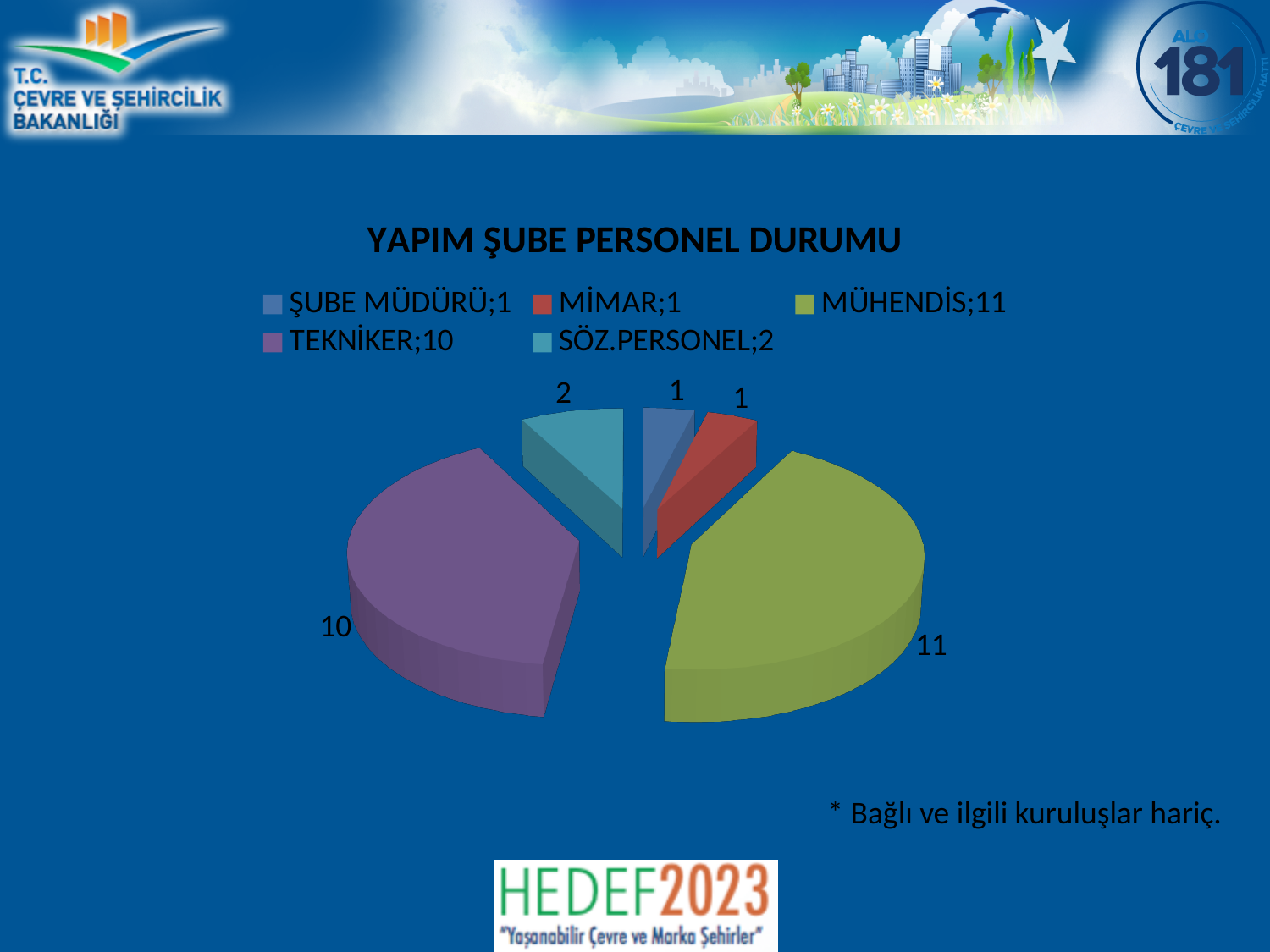
What is the difference between the values for MÜHENDİS and TEKNİKER? 1 What is the value for ŞUBE MÜDÜRÜ? 1 How many slices does the pie chart have? 5 What is the total of all slices in the pie chart? 25 What is the value for TEKNİKER? 10 Which is larger, the value for SÖZ.PERSONEL or the value for MİMAR? SÖZ.PERSONEL What share of the pie does MÜHENDİS represent? 44% What is the title of the chart? YAPIM ŞUBE PERSONEL DURUMU What is the value for MÜHENDİS? 11 What is the value for SÖZ.PERSONEL? 2 What kind of chart is shown on the slide? pie chart Which category has the largest slice? MÜHENDİS